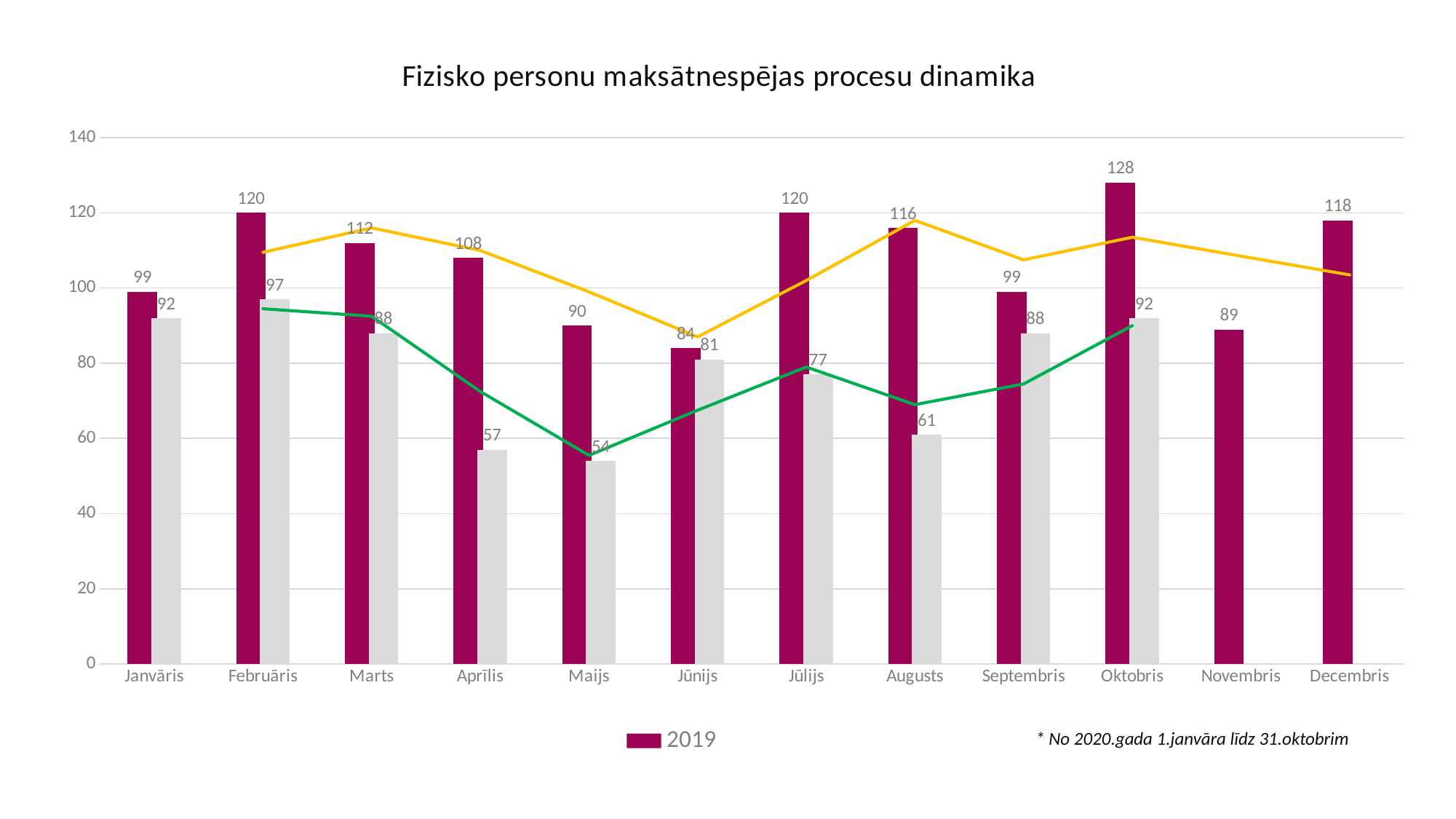
How many months are shown on the x axis? 12 What is the value of the grey bar for Maijs? 54 What is the 2019 value for Jūnijs? 84 Which is larger, the 2019 value for Marts or for Aprīlis? Marts What is the 2019 value for Oktobris? 128 What is the title of the chart? Fizisko personu maksātnespējas procesu dinamika Which month has the lowest 2019 value? Jūnijs Is the 2019 value for Decembris greater or less than 100? greater What kind of chart is this? Bar chart with line series How many series does the legend list? 1 What is the difference between the 2019 values for Oktobris and Jūnijs? 44 Which month has the highest 2019 value? Oktobris